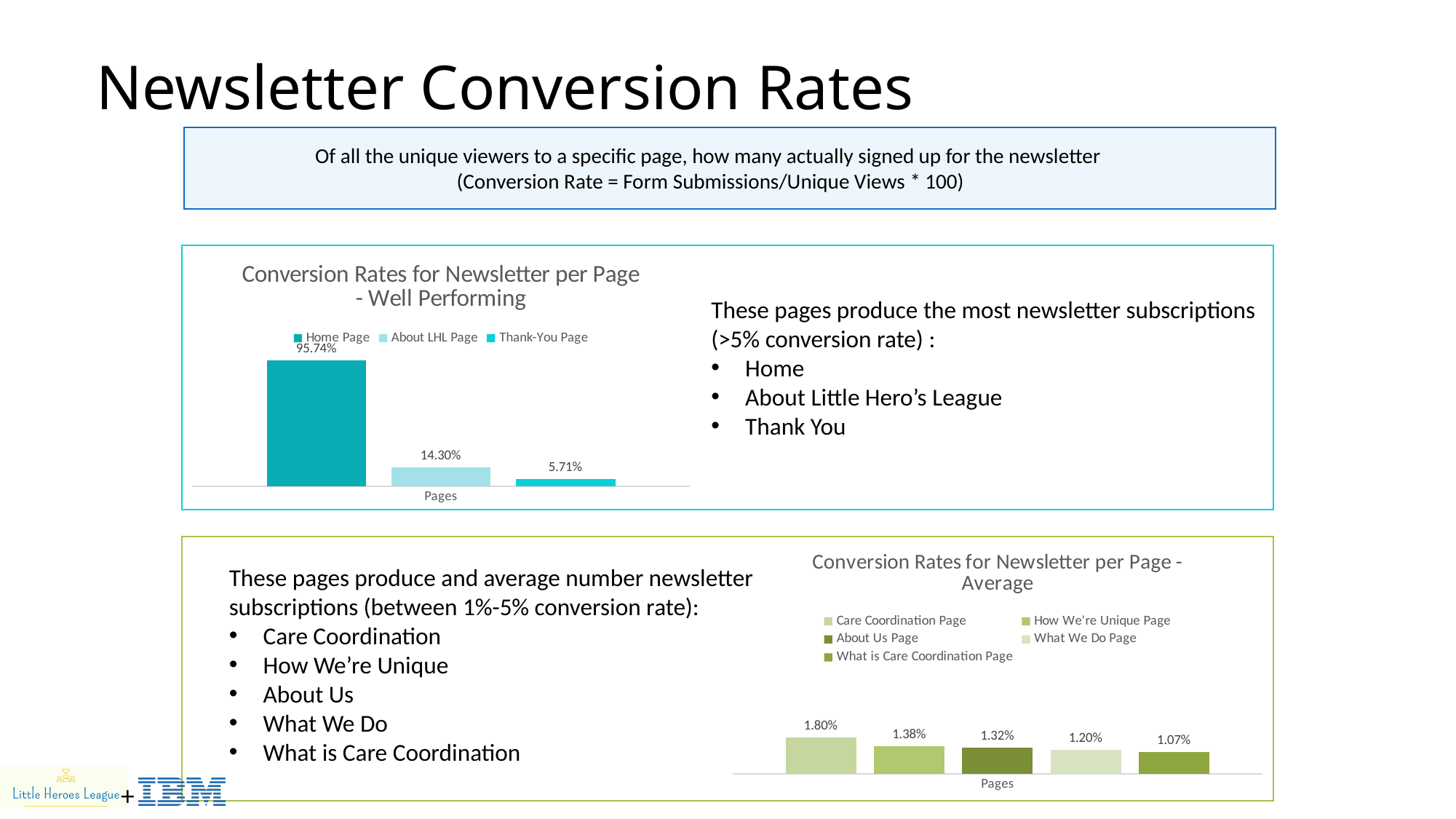
What kind of chart is the 'Well Performing' chart? Bar chart In the 'Well Performing' chart, how many series does the legend list? 3 In the 'Average' chart, which page has the lowest conversion rate? What is Care Coordination Page In the 'Average' chart, do the values rise or fall from left to right? Fall In the 'Well Performing' chart, which page has the lowest conversion rate? Thank-You Page In the 'Average' chart, how many bars are plotted? 5 In the 'Well Performing' chart, what is the difference between the Home Page and About LHL Page conversion rates? 81.44% In the 'Well Performing' chart, what is the conversion rate for the Thank-You Page? 5.71% In the 'Average' chart, which page has the highest conversion rate? Care Coordination Page In the 'Average' chart, what is the conversion rate for the What We Do Page? 1.20% In the 'Well Performing' chart, what is the conversion rate for the Home Page? 95.74% In the 'Average' chart, what is the conversion rate for the Care Coordination Page? 1.80%